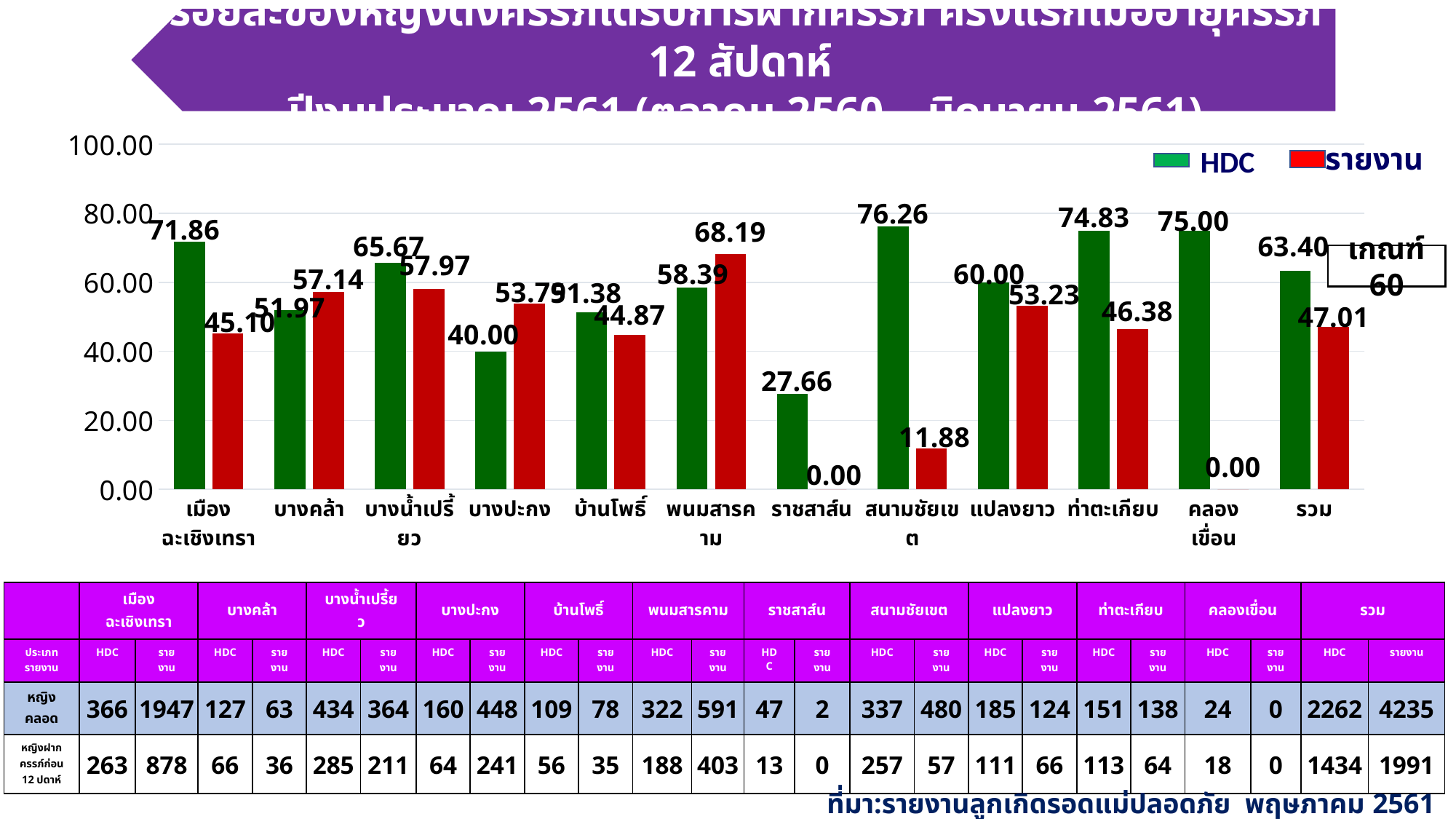
What is the HDC value for เมืองฉะเชิงเทรา? 71.86 How many series does the chart legend list? 2 Which category has the highest รายงาน value? พนมสารคาม What is the difference between the HDC and รายงาน values for เมืองฉะเชิงเทรา? 26.76 Is the HDC value for ท่าตะเกียบ greater or less than 60.00? greater For บางปะกง, which is larger: the HDC value or the รายงาน value? รายงาน How many categories are shown on the x axis of the chart? 12 What is the HDC value for รวม? 63.40 What type of chart is shown on the slide? bar chart What is the รายงาน value for พนมสารคาม? 68.19 Which category has the lowest HDC value? ราชสาส์น Which category has the highest HDC value? สนามชัยเขต